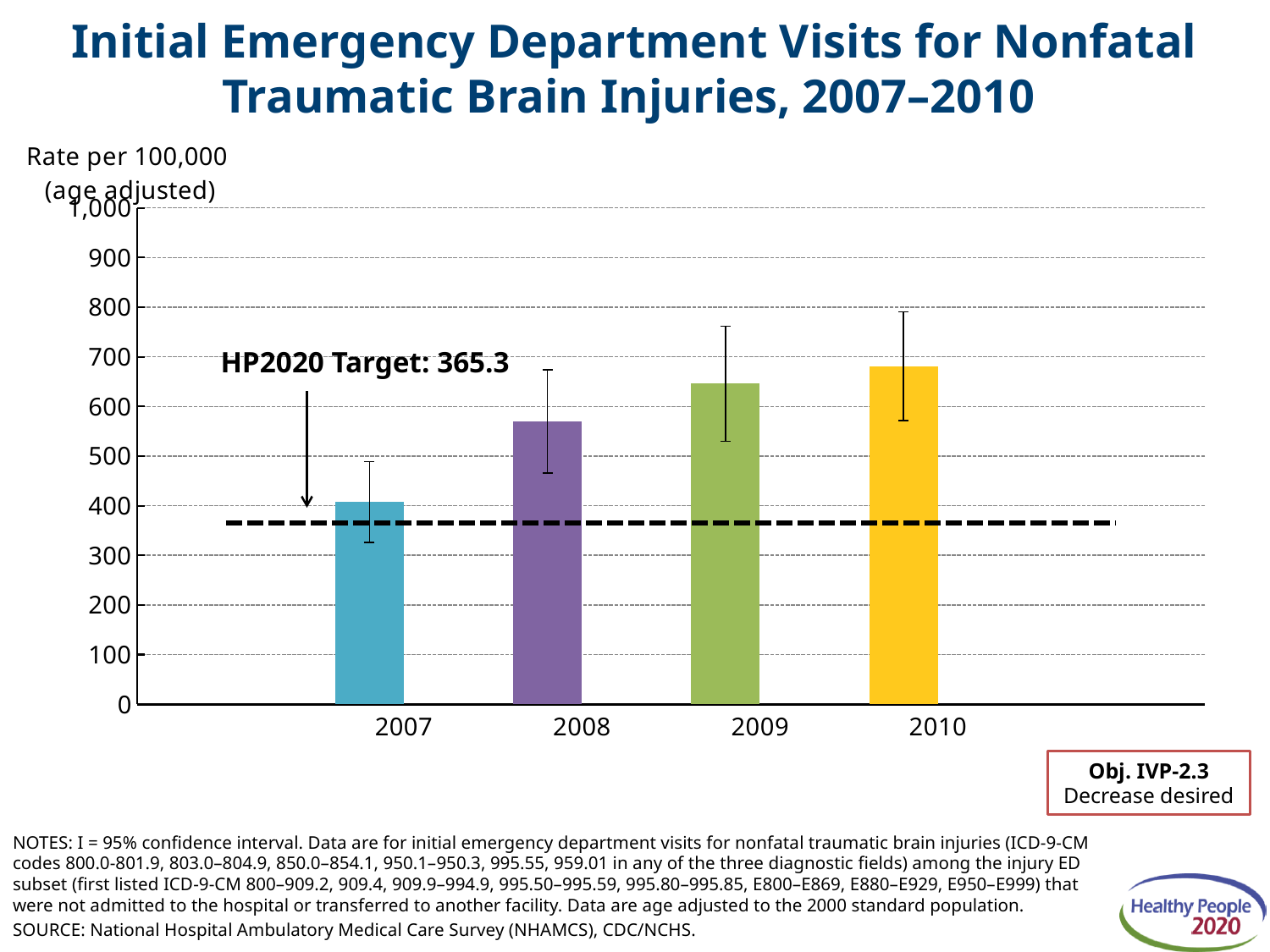
How many years are plotted on the chart? 4 What is the label of the y axis? Rate per 100,000 (age adjusted) Which year has the larger rate, 2008 or 2009? 2009 What is the HP2020 Target value shown on the chart? 365.3 What kind of chart is shown on the slide? Bar chart Do the rates rise or fall from 2007 to 2010? Rise Which year has the highest rate of initial emergency department visits? 2010 Is the value for 2010 greater or less than 700? less Is the value for 2008 greater or less than 500? greater Is the value for 2009 greater or less than 600? greater Which year has the lowest rate of initial emergency department visits? 2007